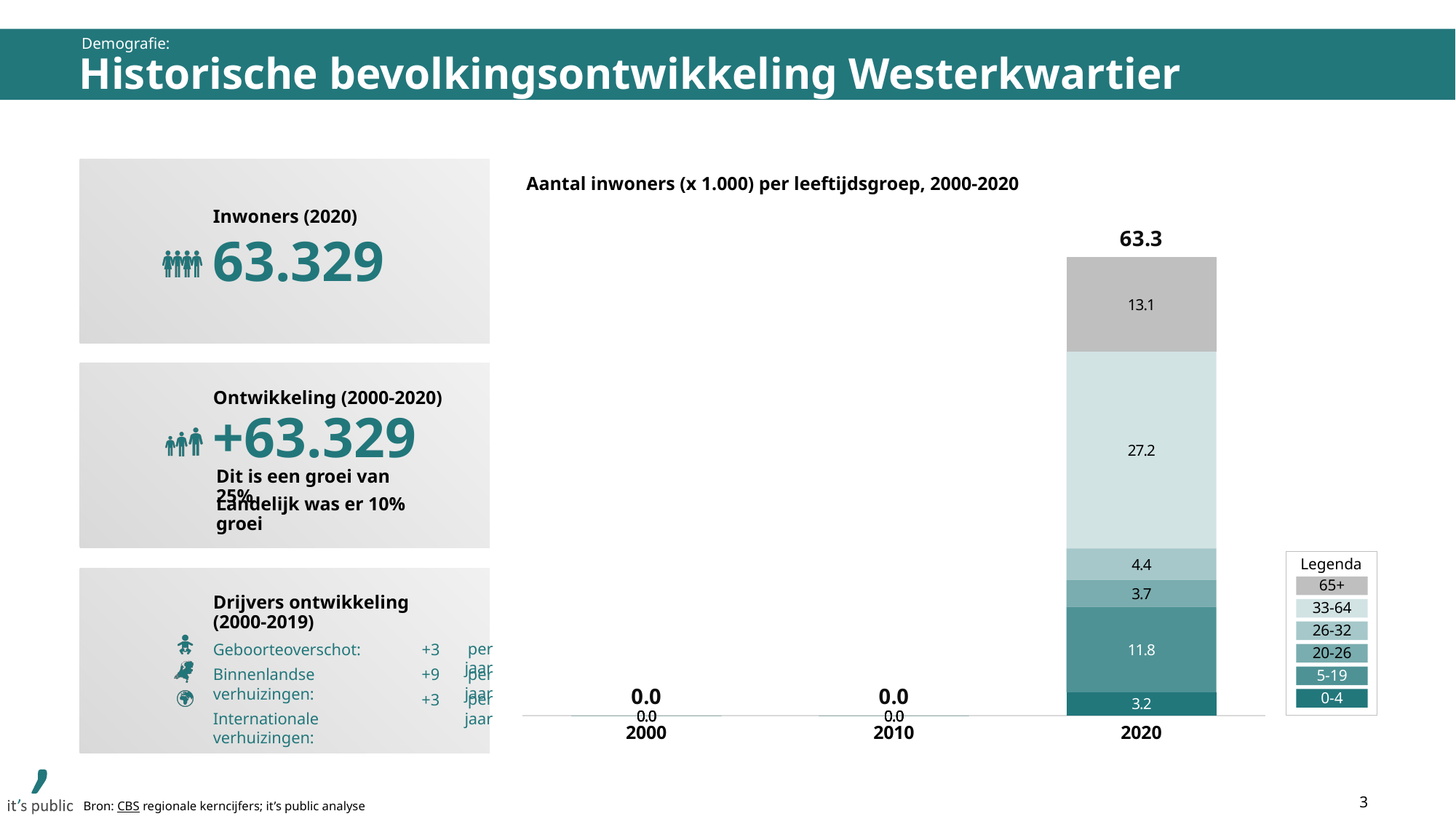
What is the value for the 0-4 age group in 2020? 3.2 What kind of chart is shown on the slide? Stacked bar chart What is the value for the 33-64 age group in 2020? 27.2 What is the difference between the 26-32 and 20-26 values in 2020? 0.7 What is the value for the 65+ age group in 2020? 13.1 Which age group has the largest value in the 2020 bar? 33-64 How many years are shown on the x axis of the chart? 3 What is the value for the 5-19 age group in 2020? 11.8 What is the title of the chart? Aantal inwoners (x 1.000) per leeftijdsgroep, 2000-2020 What is the total shown above the 2020 bar? 63.3 How many age groups does the chart legend list? 6 Which age group has the smallest value in the 2020 bar? 0-4